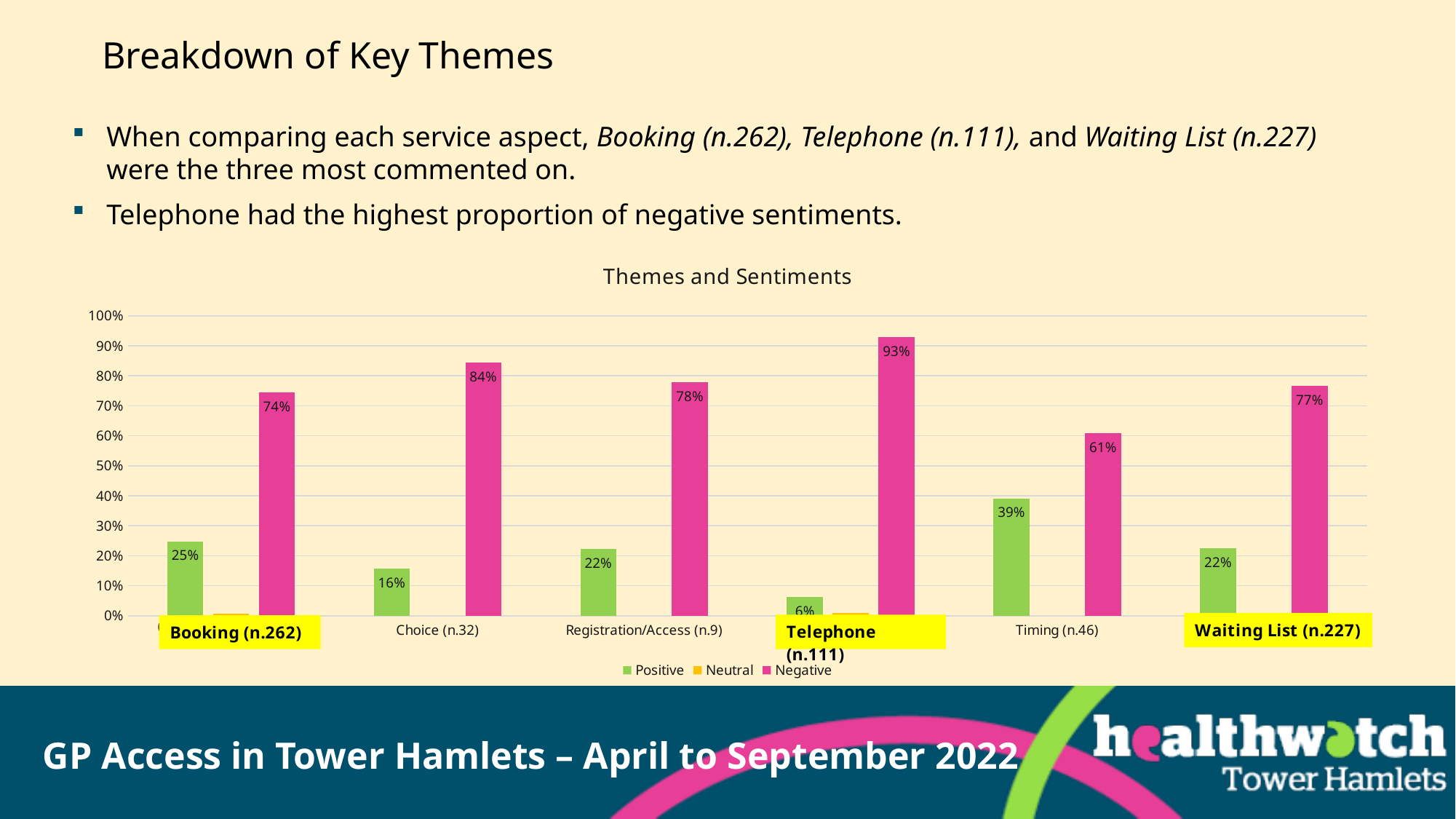
Which is larger, the Positive value for Booking (n.262) or the Positive value for Choice (n.32)? Booking (n.262) What is the difference between the Negative values for Choice (n.32) and Booking (n.262)? 10% What is the Negative value for Waiting List (n.227)? 77% Is the Negative value for Registration/Access (n.9) greater or less than 70%? greater How many categories are shown on the x axis? 6 What is the Negative value for Telephone (n.111)? 93% What type of chart is shown? Bar chart Which category has the lowest Negative value? Timing (n.46) How many series does the legend list? 3 Which category has the highest Negative value? Telephone (n.111) What is the Positive value for Timing (n.46)? 39% Which category has the lowest Positive value? Telephone (n.111)